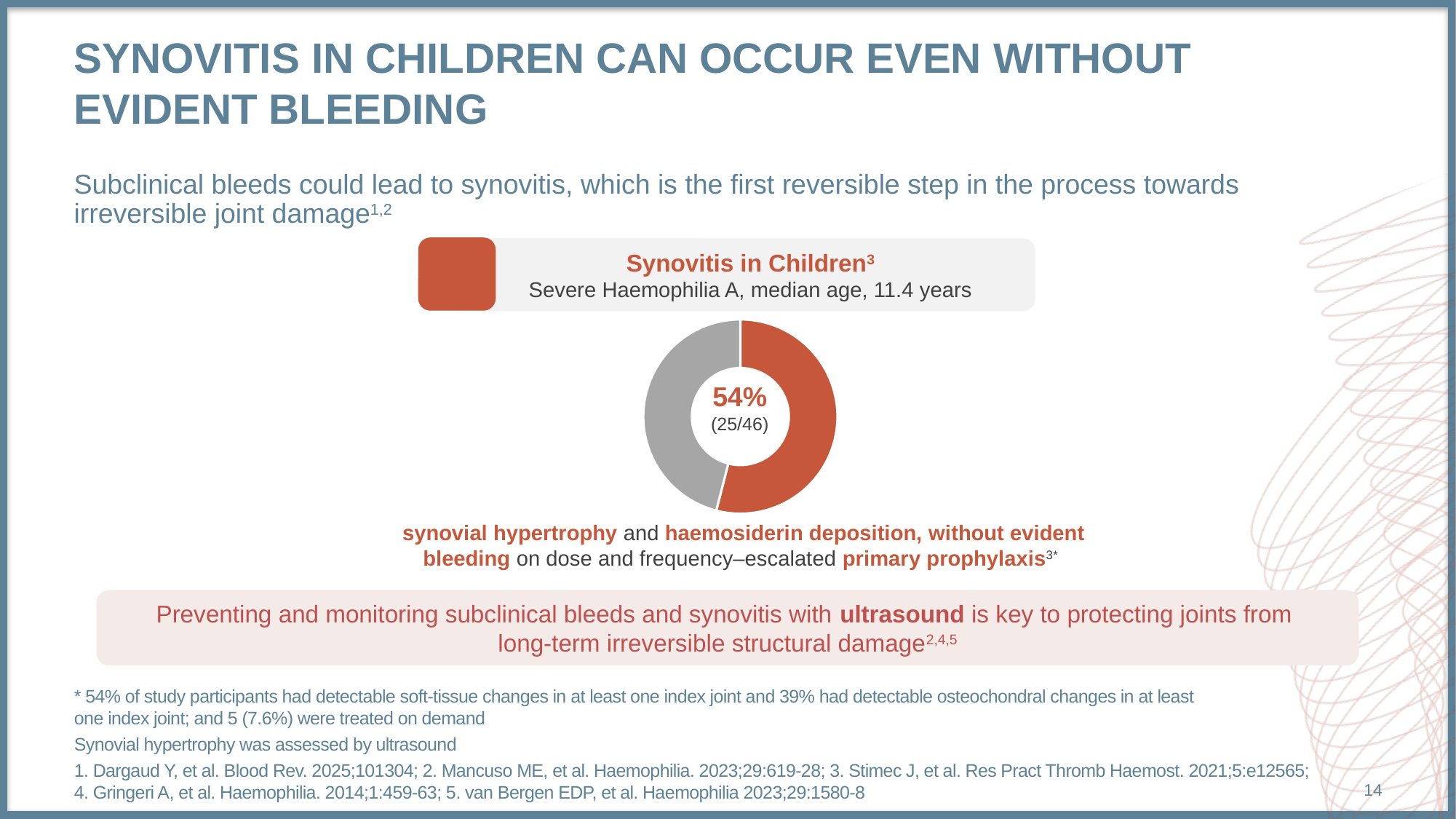
Which slice of the donut chart is larger, the red one or the grey one? The red one What kind of chart is shown on the slide? Donut (pie) chart Is the red slice of the donut chart greater or less than 50%? greater How many slices does the donut chart have? 2 How many children in total does the donut chart's fraction refer to? 46 What colour is the slice representing 54% in the donut chart? Red What fraction is printed beneath the 54% in the donut chart? 25/46 What percentage is shown in the centre of the donut chart? 54% What share of the donut chart does the red (highlighted) slice represent? 54% How many children does the 54% slice of the donut chart correspond to? 25 What is the title of the chart? Synovitis in Children